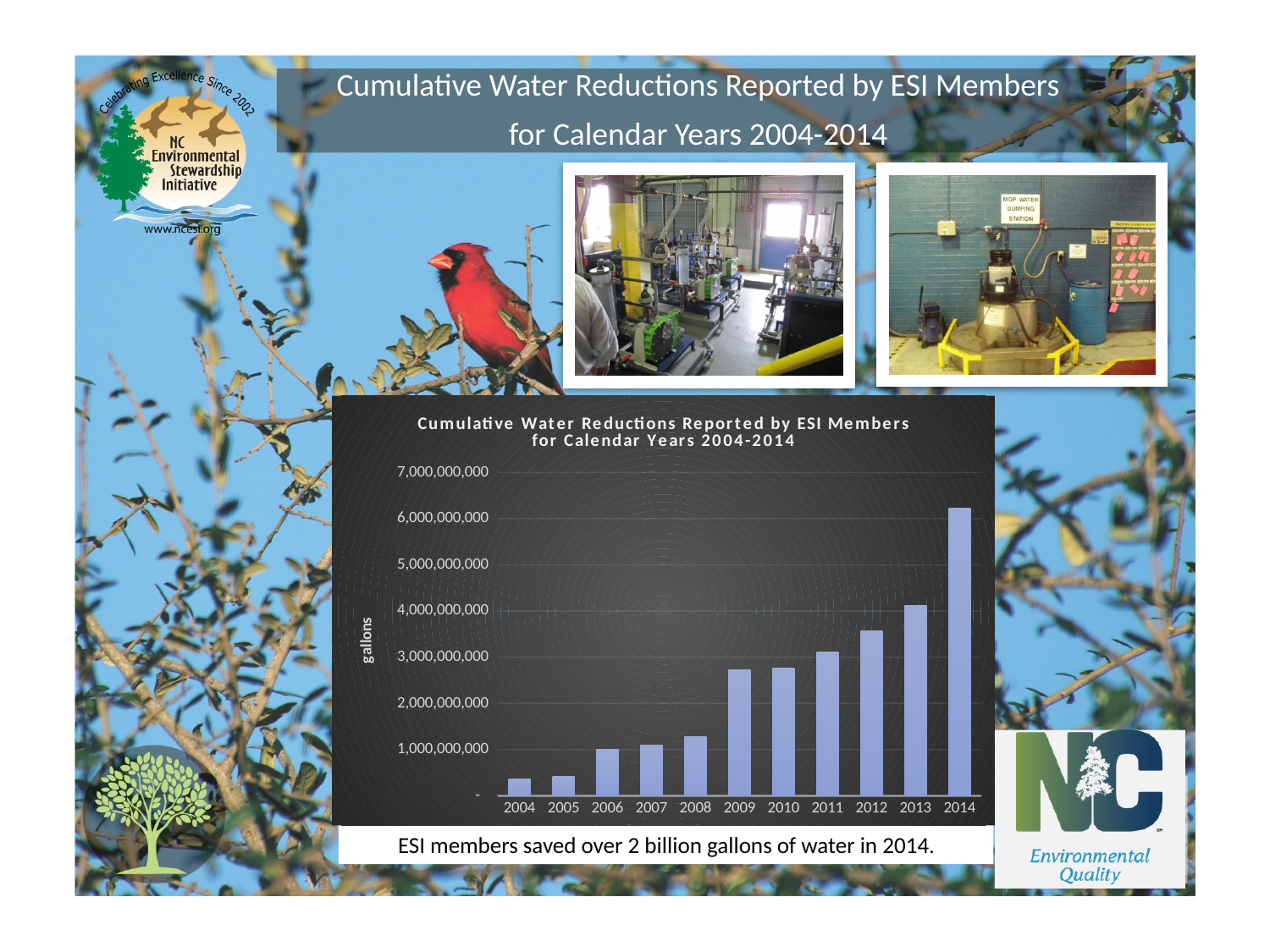
Which year has the highest cumulative water reduction in the chart? 2014 Which year has the larger value, 2013 or 2014? 2014 Do the values generally rise or fall from 2004 to 2014? rise Is the value for 2014 greater or less than 6,000,000,000? greater Is the value for 2012 greater or less than 3,000,000,000? greater How many years are plotted on the x axis of the chart? 11 Is the value for 2009 greater or less than 3,000,000,000? less What kind of chart is shown on the slide? bar chart What is the label on the vertical axis of the chart? gallons Which year has the lowest cumulative water reduction in the chart? 2004